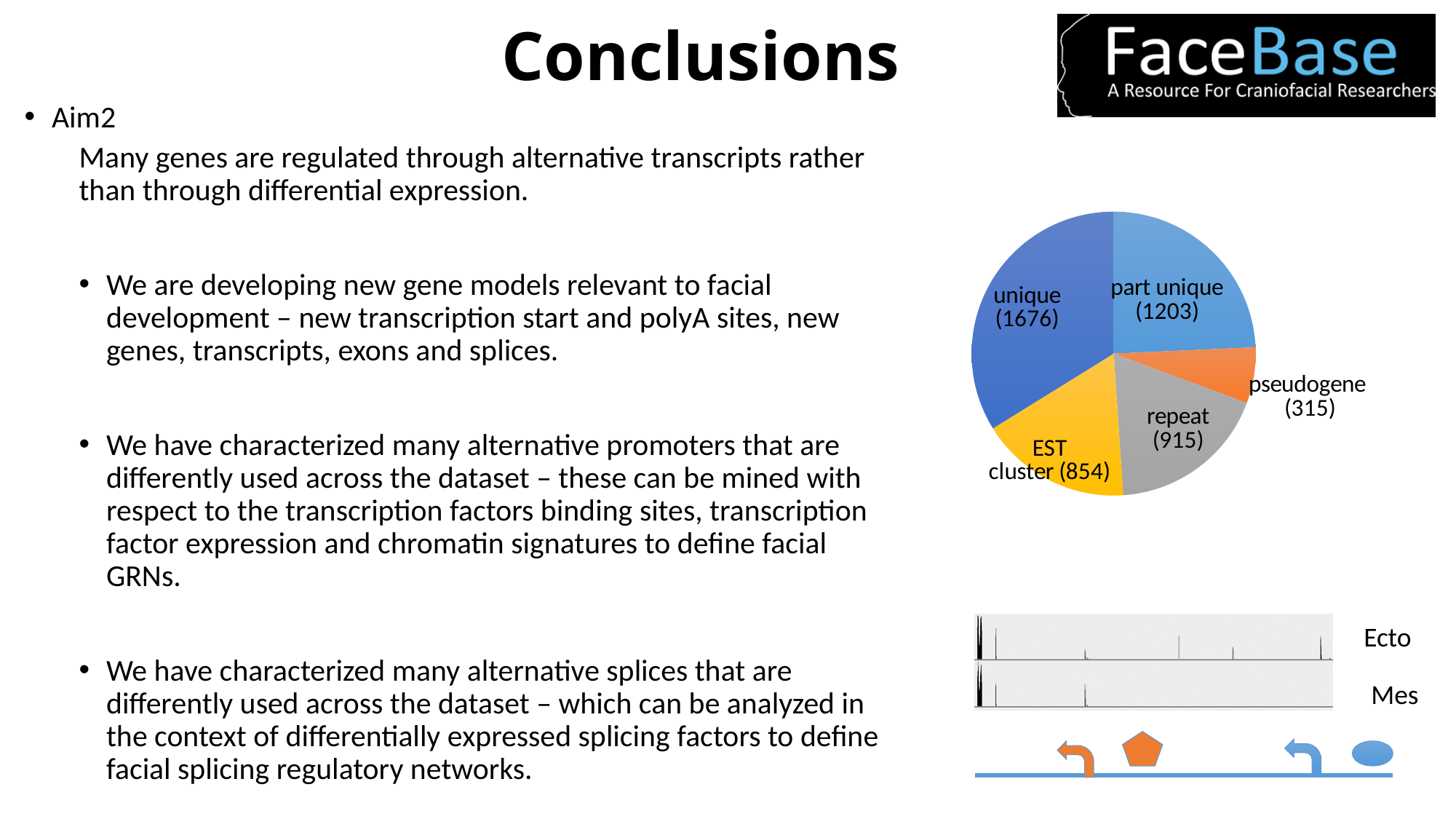
What is the value for the 'part unique' slice in the pie chart? 1203 What is the total of all the values shown in the pie chart? 4963 Which category has the largest slice in the pie chart? unique What is the value for the 'repeat' slice in the pie chart? 915 What is the difference between the 'unique' and 'part unique' values in the pie chart? 473 Which is larger in the pie chart, 'repeat' or 'EST cluster'? repeat What type of chart is shown on the slide? pie chart Which category has the smallest slice in the pie chart? pseudogene What is the value for the 'unique' slice in the pie chart? 1676 How many slices does the pie chart have? 5 What is the value for the 'pseudogene' slice in the pie chart? 315 What is the value for the 'EST cluster' slice in the pie chart? 854